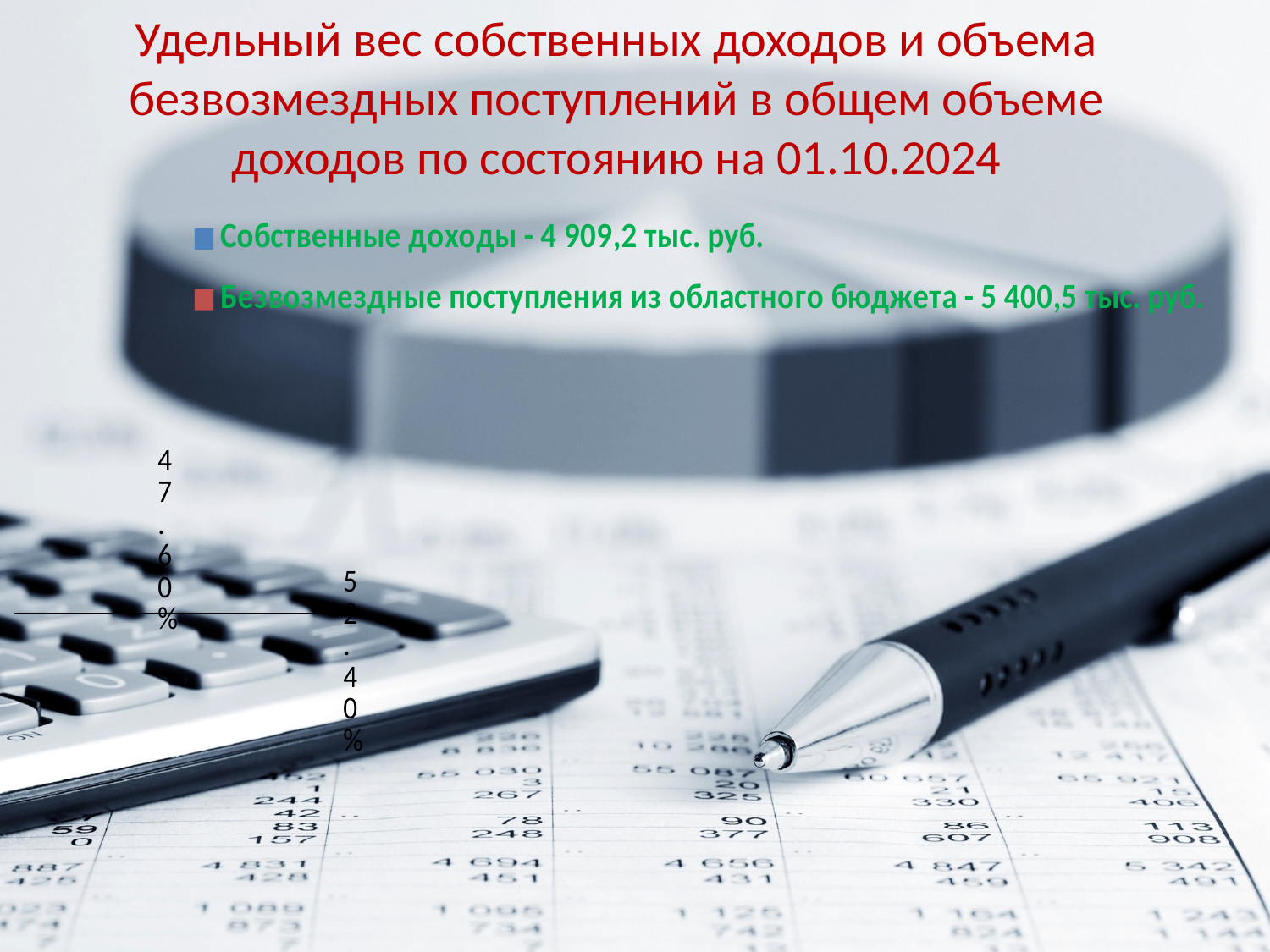
According to the legend, what is the value for Безвозмездные поступления из областного бюджета? 5 400,5 тыс. руб. Which is larger: Собственные доходы or Безвозмездные поступления из областного бюджета? Безвозмездные поступления из областного бюджета Which category has the highest value in the legend? Безвозмездные поступления из областного бюджета What is the difference between Безвозмездные поступления из областного бюджета and Собственные доходы? 491,3 тыс. руб. How many entries does the legend list? 2 What is the total of Собственные доходы and Безвозмездные поступления из областного бюджета? 10 309,7 тыс. руб. What is the larger of the two percentage data labels shown on the chart? 52.40% How many categories are shown in the chart legend? 2 What is the smaller of the two percentage data labels shown on the chart? 47.60% According to the legend, what is the value for Собственные доходы? 4 909,2 тыс. руб. Which category has the lowest value in the legend? Собственные доходы What colour is the legend marker for Собственные доходы? Blue